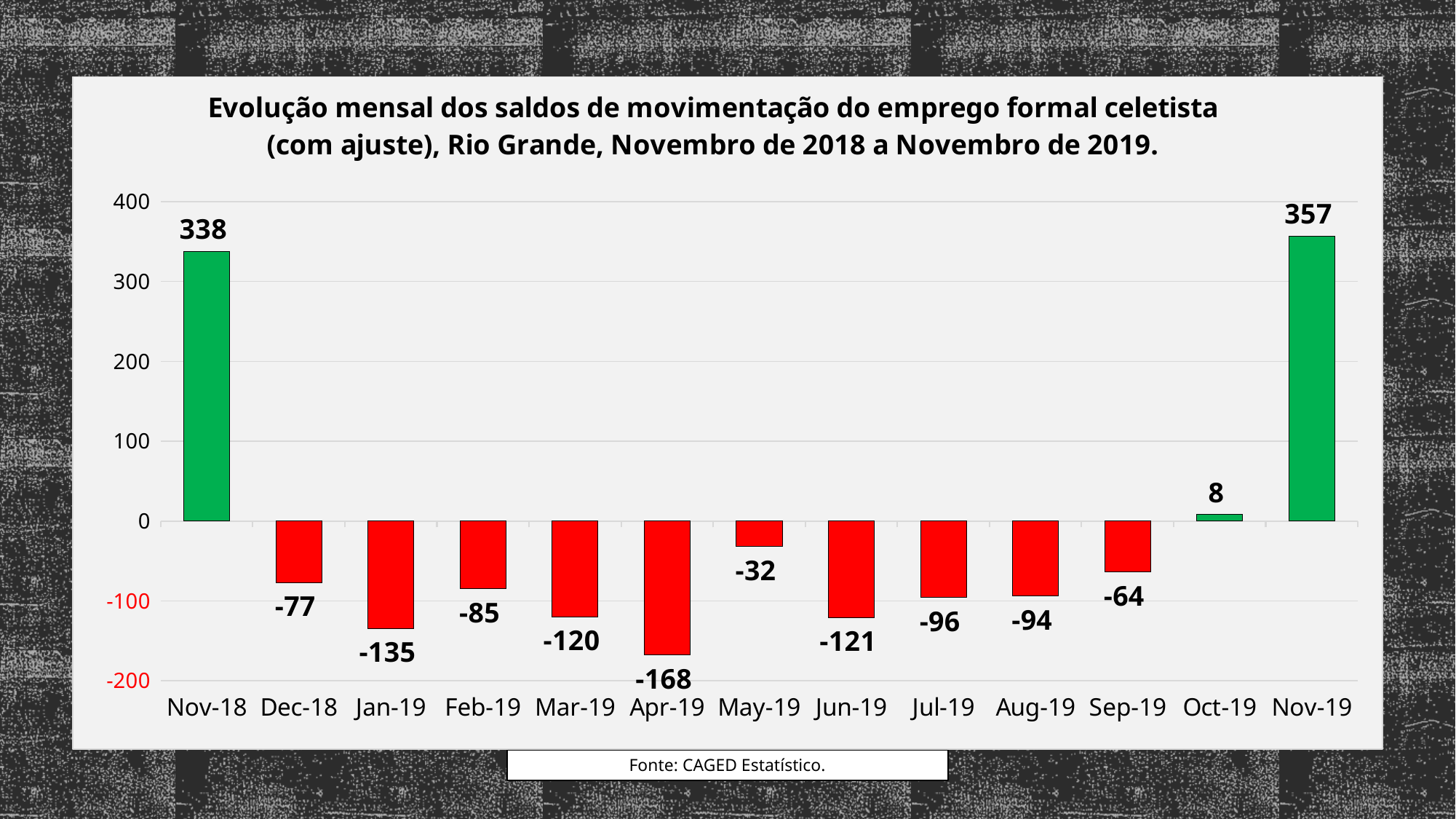
How many months have negative values? 10 What is the difference between the values for Nov-19 and Nov-18? 19 What kind of chart is this? Bar chart What is the value for Apr-19? -168 What is the value for Nov-18? 338 Which month has the lowest value? Apr-19 What is the value for Sep-19? -64 Which month has the highest value? Nov-19 What is the value for Oct-19? 8 Which is larger, the value for Jan-19 or the value for Jun-19? Jun-19 What colour are the bars with positive values? Green How many months are shown on the x axis? 13